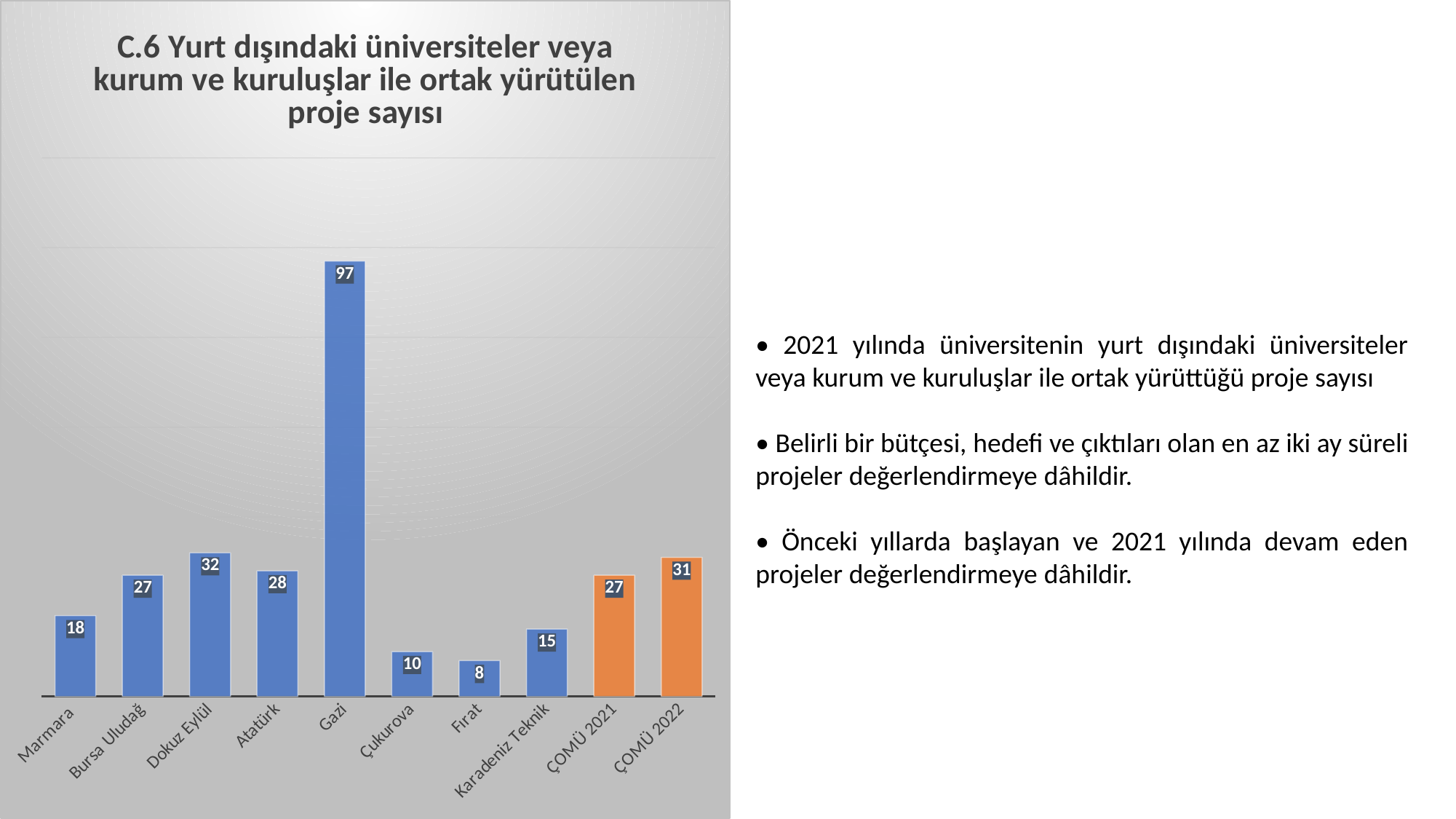
What is the difference between the values for Gazi and Dokuz Eylül? 65 Which bars are coloured orange rather than blue? ÇOMÜ 2021 and ÇOMÜ 2022 What is the value for Fırat? 8 What is the value for ÇOMÜ 2022? 31 Which is larger, the value for Atatürk or the value for Dokuz Eylül? Dokuz Eylül How many categories are shown on the x axis? 10 What is the difference between the values for ÇOMÜ 2022 and ÇOMÜ 2021? 4 Which category has the lowest value? Fırat What is the value for Gazi? 97 Which category has the highest value? Gazi What kind of chart is shown on the slide? Bar chart Which is larger, the value for Marmara or the value for Karadeniz Teknik? Marmara